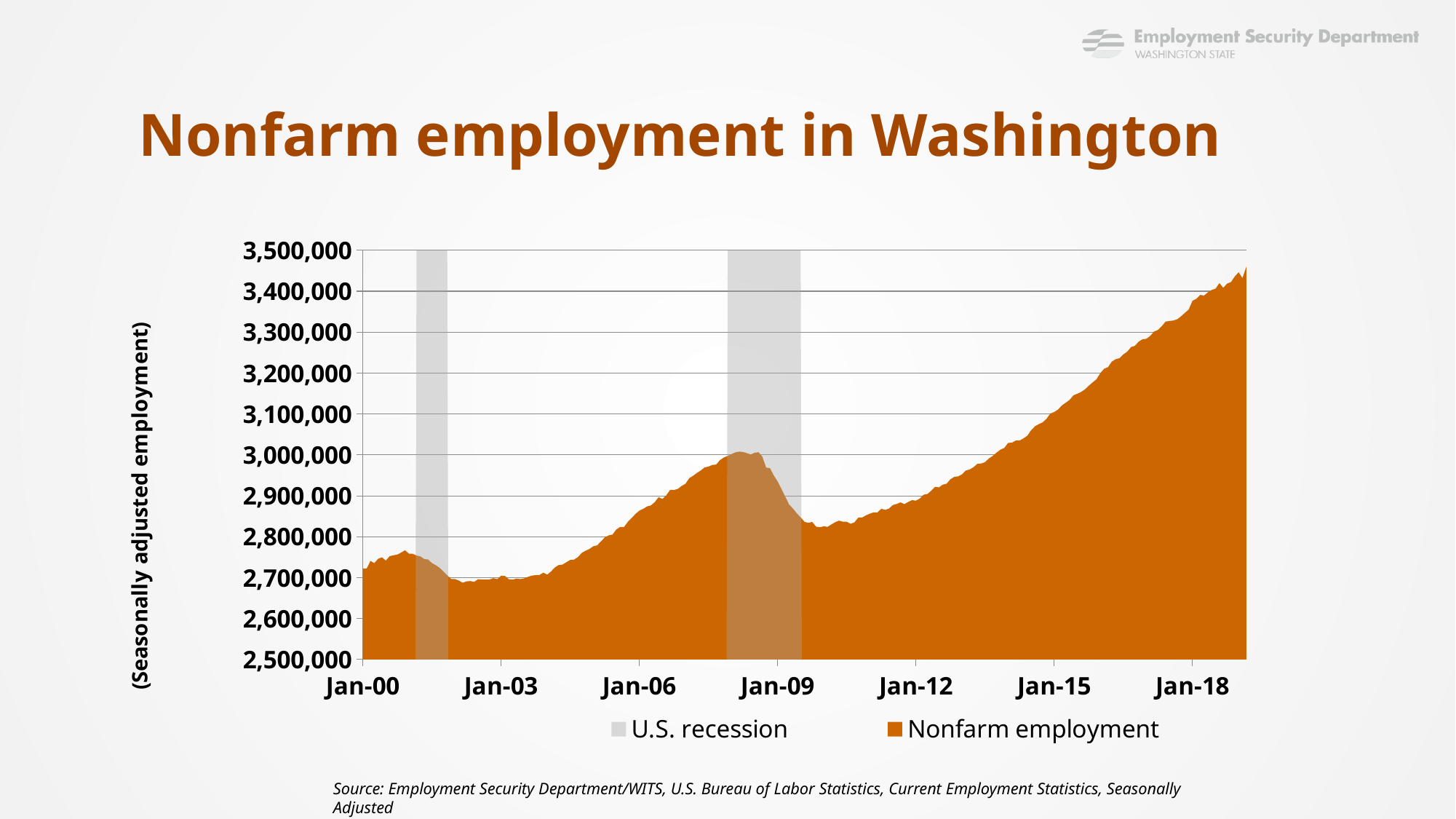
Is the value for Jan-00 greater or less than 2,800,000? less Does nonfarm employment rise or fall between Jan-12 and Jan-18? rise What is the title of the chart? Nonfarm employment in Washington Is the value for Jan-15 greater or less than 3,000,000? greater Is the value for Jan-18 greater or less than 3,300,000? greater How many entries does the legend list? 2 What does the y-axis label say? (Seasonally adjusted employment) What kind of chart is shown on the slide? area chart Which is larger, the value at Jan-18 or the value at Jan-09? Jan-18